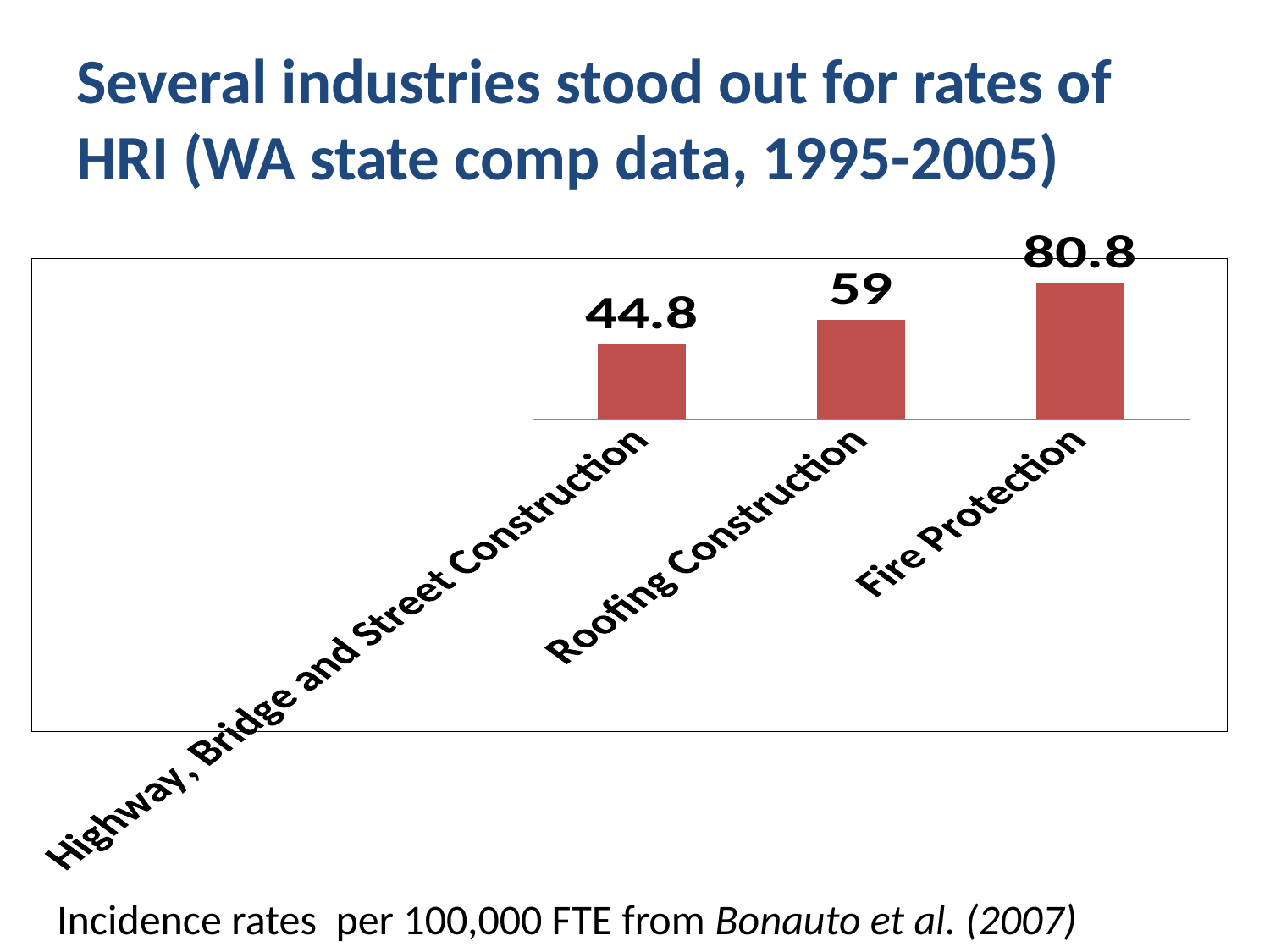
What colour are the bars in the chart? red Which category has the lowest value? Highway, Bridge and Street Construction Which category has the highest value? Fire Protection What is the value for Fire Protection? 80.8 What is the difference between the values for Fire Protection and Roofing Construction? 21.8 What is the value for Highway, Bridge and Street Construction? 44.8 What is the difference between the values for Roofing Construction and Highway, Bridge and Street Construction? 14.2 What kind of chart is shown on the slide? bar chart What is the value for Roofing Construction? 59 Do the values rise or fall from left to right across the categories? rise Which is larger, the value for Roofing Construction or the value for Highway, Bridge and Street Construction? Roofing Construction How many categories are shown in the chart? 3